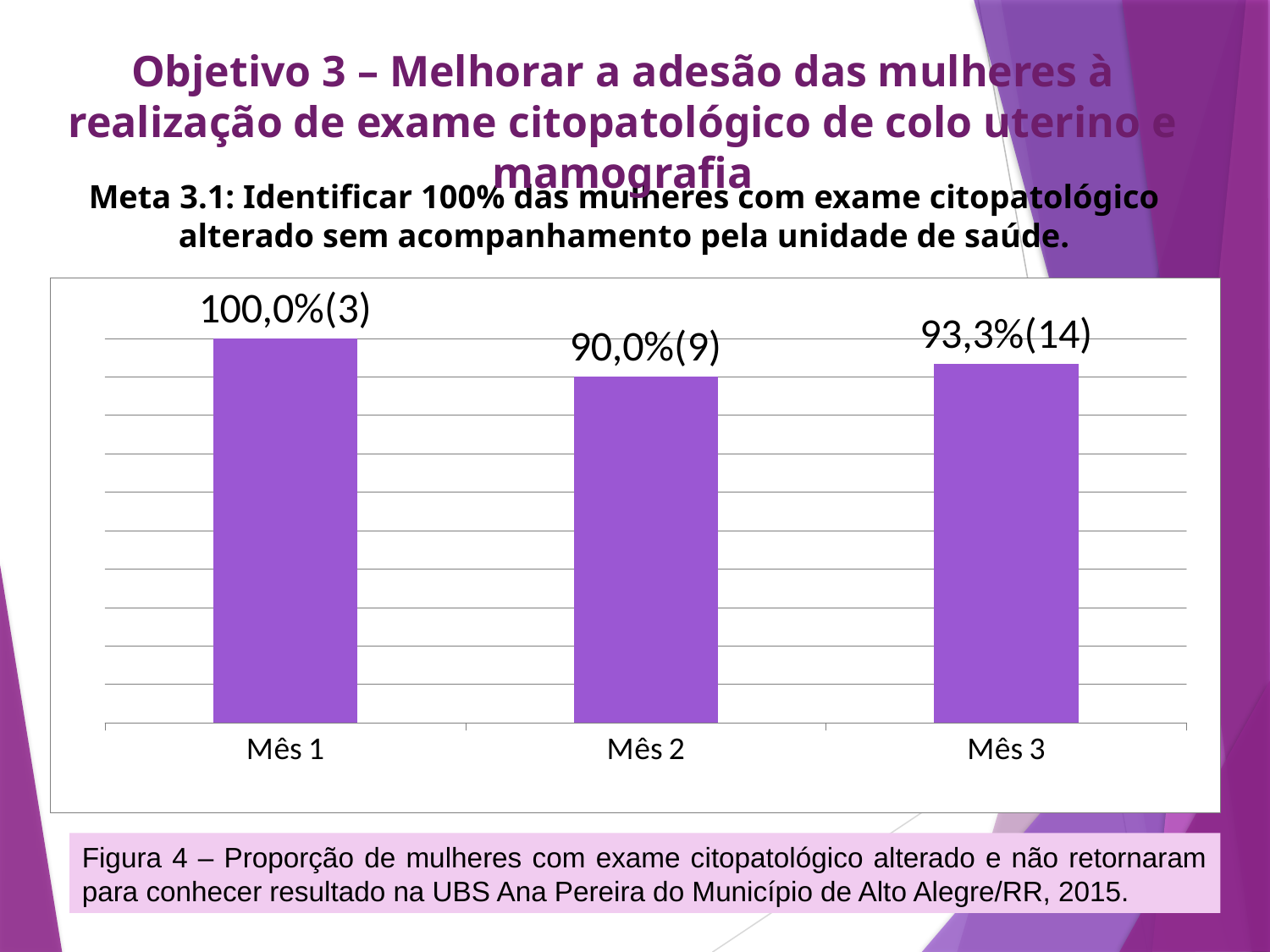
Which month has the lowest proportion? Mês 2 How many more women are counted in parentheses for Mês 3 than for Mês 2? 5 What is the difference in percentage between Mês 1 and Mês 2? 10,0% What value is shown for Mês 3? 93,3%(14) What kind of chart is shown on the slide? Bar chart Does the proportion rise or fall from Mês 1 to Mês 2? Fall What value is shown for Mês 2? 90,0%(9) How many months (categories) are shown on the x axis? 3 Which month has the highest proportion? Mês 1 Which is larger, the proportion for Mês 2 or for Mês 3? Mês 3 What value is shown for Mês 1? 100,0%(3) What is the difference in percentage between Mês 3 and Mês 2? 3,3%